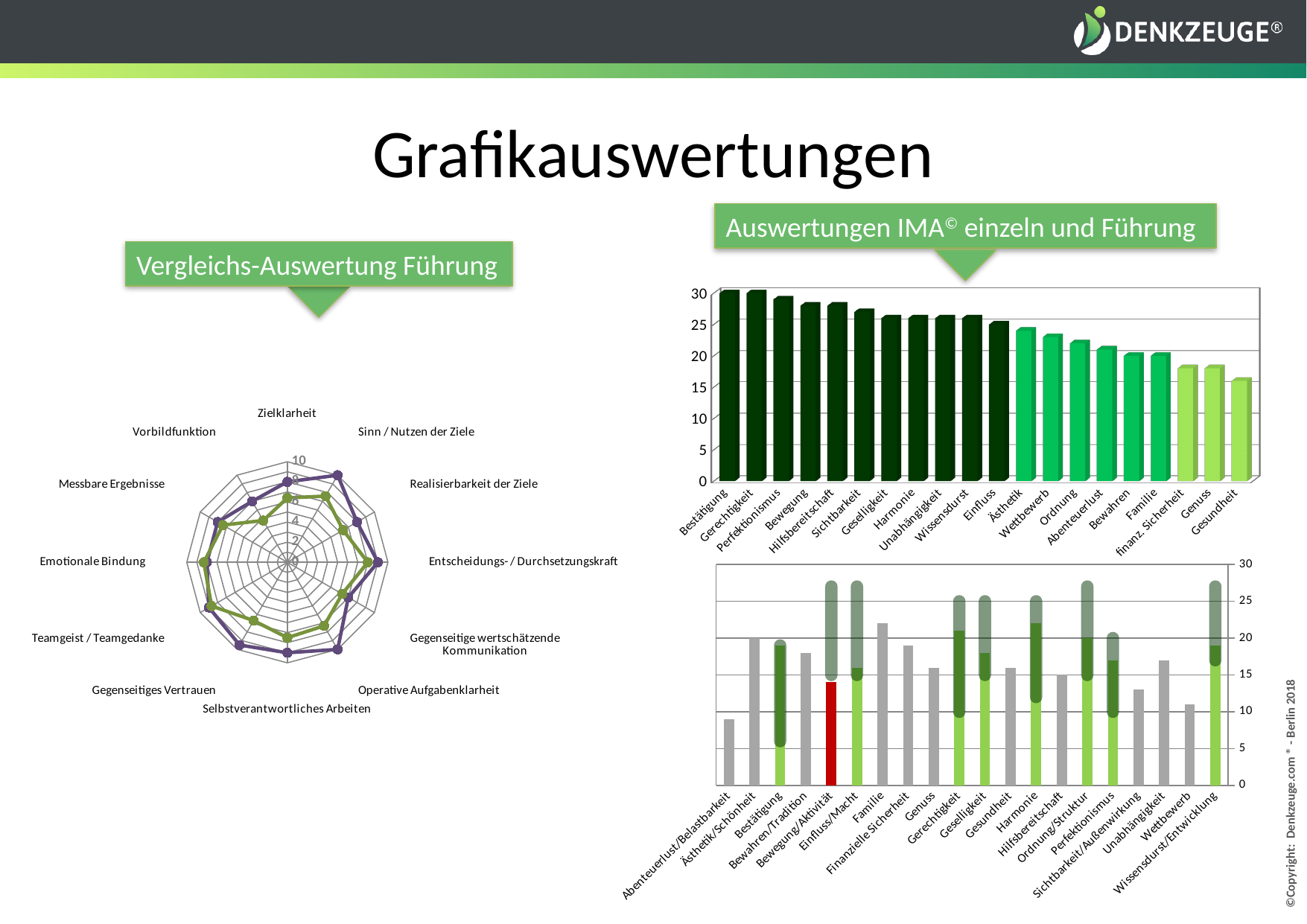
How many categories are shown in the top-right bar chart? 20 In the top-right bar chart, do the values rise or fall from left to right along the x axis? fall What is the maximum value shown on the scale of the radar chart on the left of the slide? 10 In the top-right bar chart, which is larger, the value for Einfluss or the value for Wettbewerb? Einfluss How many categories (axes) does the radar chart on the left of the slide have? 12 In the top-right bar chart, which category has the lowest value? Gesundheit In the bottom-right bar chart, which category is drawn as a red bar? Bewegung/Aktivität What kind of chart is the chart on the left of the slide, under the heading 'Vergleichs-Auswertung Führung'? radar chart How many categories are shown in the bottom-right bar chart? 20 In the top-right bar chart, is the value for Genuss greater or less than 20? less In the top-right bar chart, is the value for Bestätigung greater or less than 25? greater What kind of chart is the top-right chart on the slide? bar chart